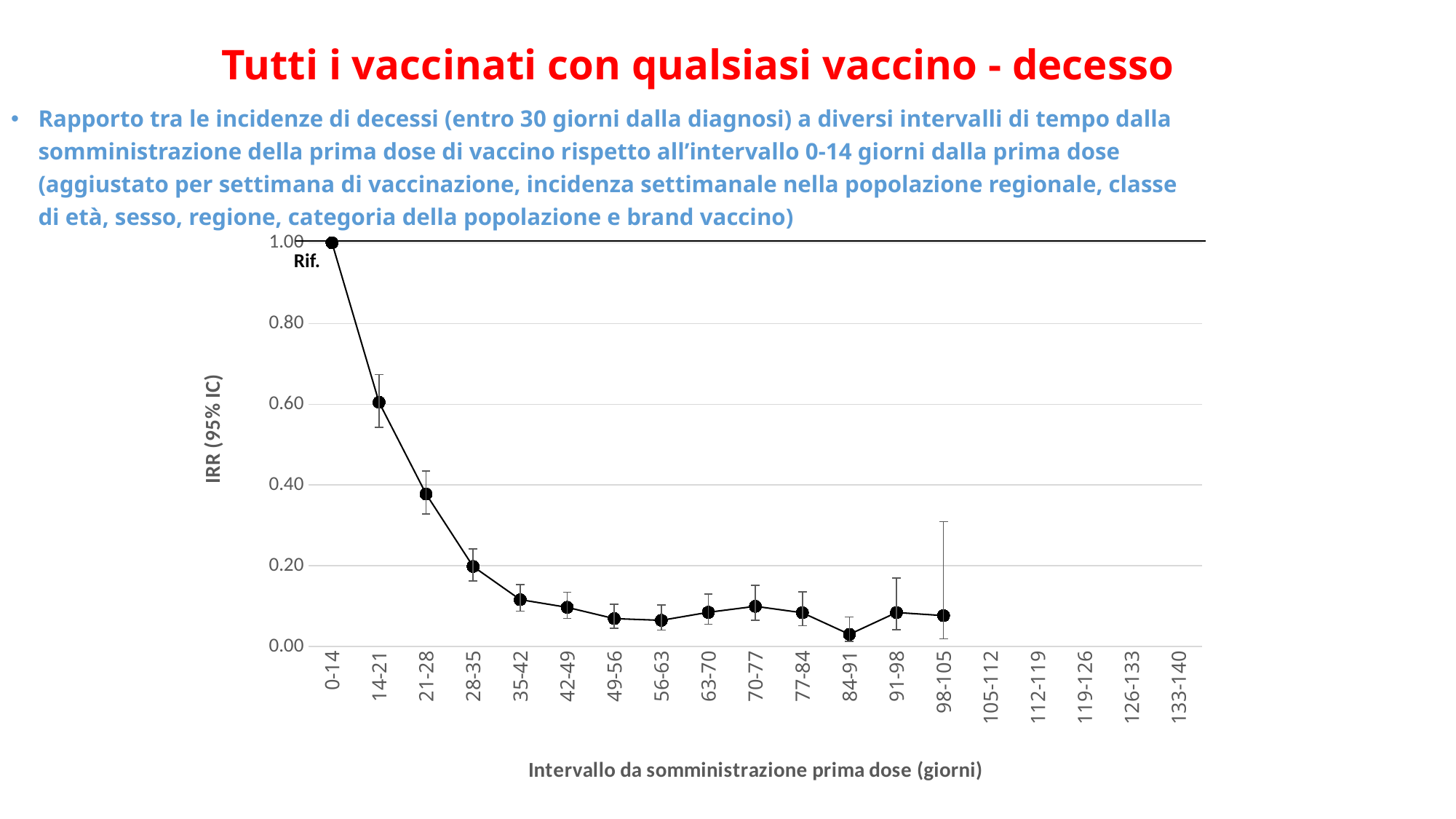
Is the IRR value for the 14-21 interval greater or less than 0.40? greater How many data points are plotted on the line? 14 Do the IRR values generally rise or fall as the interval from the first dose increases? fall Which has a larger IRR value, the 14-21 interval or the 28-35 interval? 14-21 Is the IRR value for the 14-21 interval greater or less than 0.80? less What is the title of the y axis? IRR (95% IC) Which interval has the highest IRR value? 0-14 Is the IRR value for the 35-42 interval greater or less than 0.20? less What kind of chart is shown on the slide? line chart Which interval has the lowest IRR value? 84-91 What is the IRR value for the 0-14 day interval? 1.00